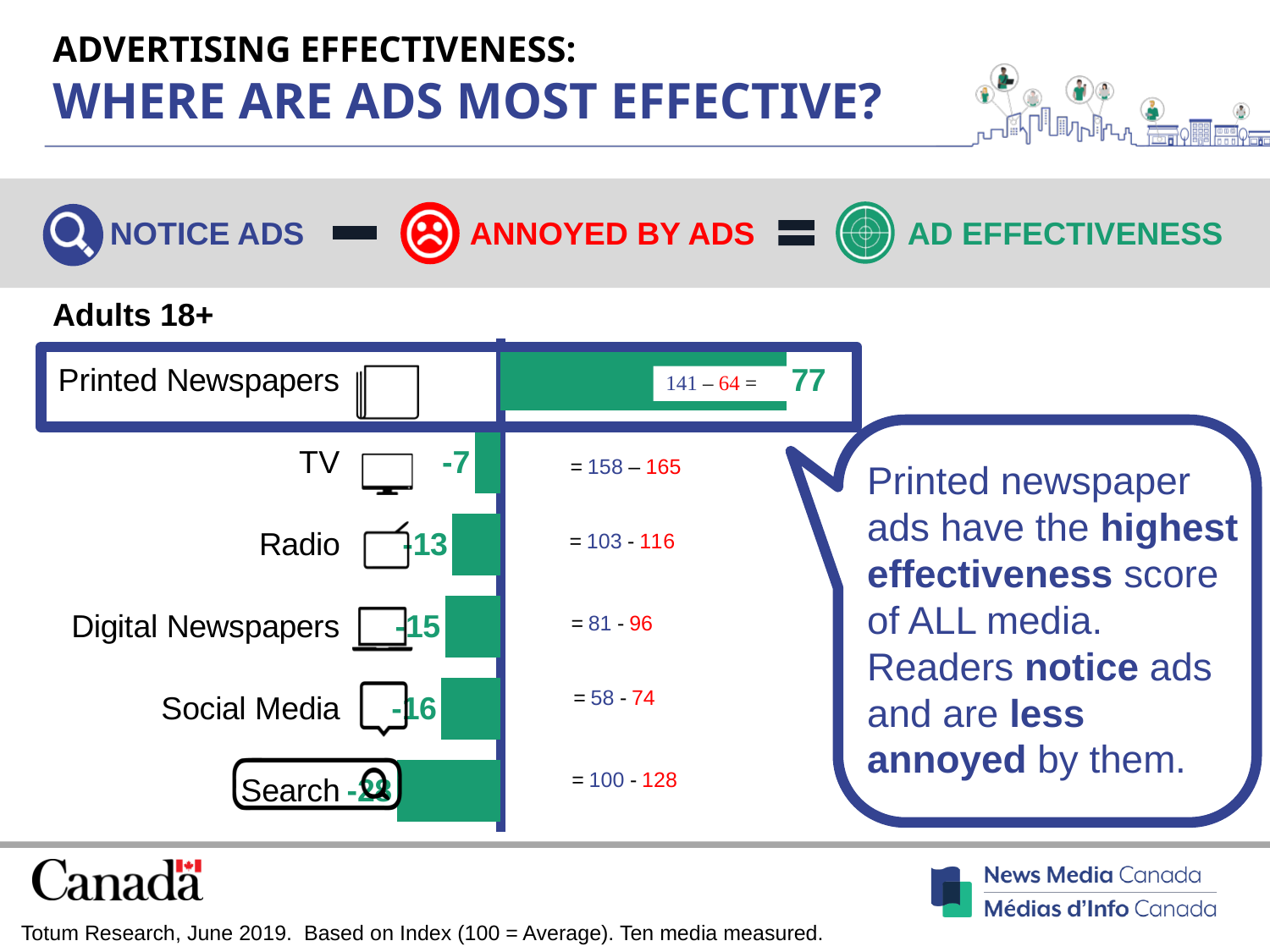
What is the ad effectiveness score for Social Media? -16 What is the difference between the ad effectiveness scores of Printed Newspapers and TV? 84 What is the ad effectiveness score for Printed Newspapers? 77 Which has a higher ad effectiveness score, TV or Social Media? TV What is the ad effectiveness score for TV? -7 What kind of chart is shown on the slide? Bar chart What is the ad effectiveness score for Digital Newspapers? -15 How many media are shown in the chart? 6 What age group does the chart cover? Adults 18+ Which medium has the lowest ad effectiveness score? Search Which medium has the highest ad effectiveness score? Printed Newspapers What is the ad effectiveness score for Radio? -13